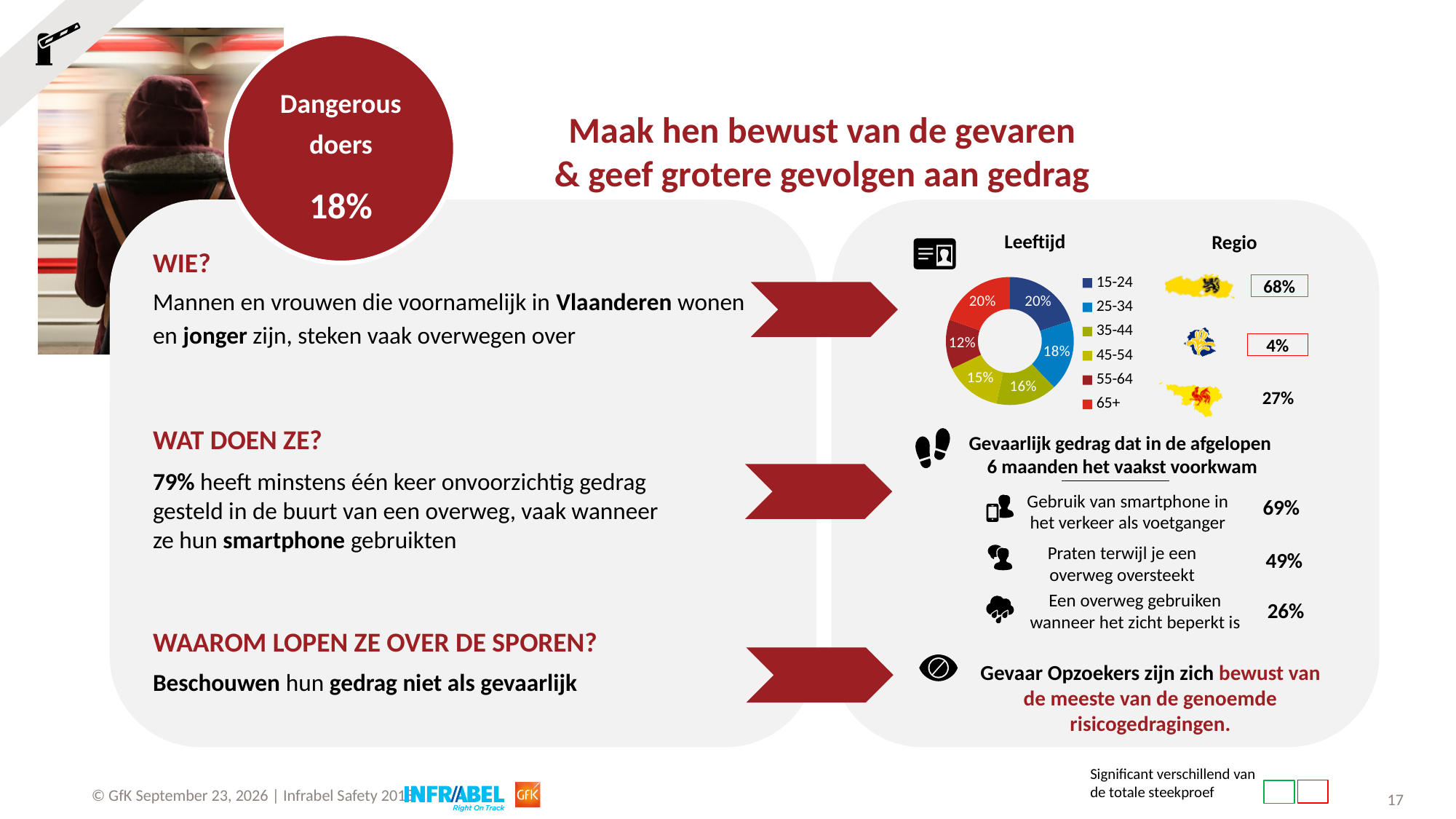
In the Leeftijd chart, what share is the 45-54 age group? 15% In the Leeftijd chart, how many age groups does the legend list? 6 In the Leeftijd chart, what colour is the 15-24 segment? dark blue In the Leeftijd chart, what share is the 65+ age group? 20% In the Leeftijd chart, what share is the 35-44 age group? 16% What kind of chart is the Leeftijd chart? doughnut chart In the Leeftijd chart, which age group has the smallest share? 55-64 In the Leeftijd chart, what is the difference between the 25-34 share and the 55-64 share? 6% In the Leeftijd chart, what share is the 25-34 age group? 18% In the Leeftijd chart, what share is the 15-24 age group? 20% In the Leeftijd chart, which is larger: the 35-44 share or the 45-54 share? 35-44 What is the title of the doughnut chart on the slide? Leeftijd